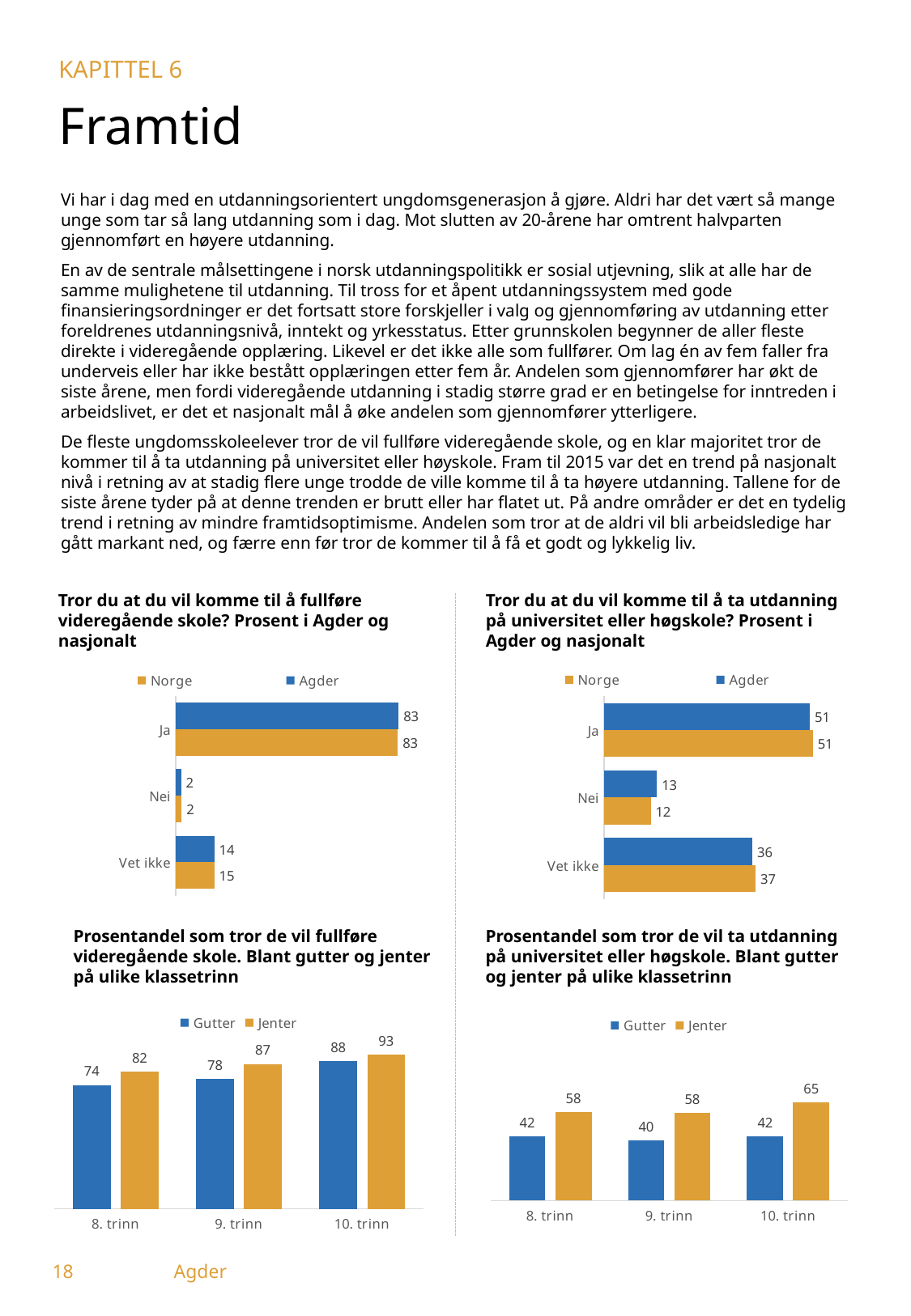
In the top-right chart (Tror du at du vil komme til å ta utdanning på universitet eller høgskole?), what is the value for Norge for 'Vet ikke'? 37 In the bottom-left chart (Prosentandel som tror de vil fullføre videregående skole), do the values for Gutter rise or fall from 8. trinn to 10. trinn? rise In the bottom-left chart (Prosentandel som tror de vil fullføre videregående skole), what is the difference between Jenter and Gutter in 8. trinn? 8 In the bottom-right chart (Prosentandel som tror de vil ta utdanning på universitet eller høgskole), which class level has the highest value for Jenter? 10. trinn In the top-right chart (Tror du at du vil komme til å ta utdanning på universitet eller høgskole?), what is the difference between Agder and Norge for 'Nei'? 1 In the top-left chart (Tror du at du vil komme til å fullføre videregående skole?), which category has the lowest values? Nei In the top-left chart (Tror du at du vil komme til å fullføre videregående skole?), what is the value for Norge for 'Vet ikke'? 15 In the top-left chart (Tror du at du vil komme til å fullføre videregående skole?), what is the value for Agder for 'Ja'? 83 In the bottom-right chart (Prosentandel som tror de vil ta utdanning på universitet eller høgskole), what is the value for Gutter in 9. trinn? 40 What kind of chart is the bottom-right chart (Prosentandel som tror de vil ta utdanning på universitet eller høgskole)? bar chart In the top-right chart (Tror du at du vil komme til å ta utdanning på universitet eller høgskole?), how many series does the legend list? 2 In the bottom-left chart (Prosentandel som tror de vil fullføre videregående skole), what is the value for Jenter in 9. trinn? 87